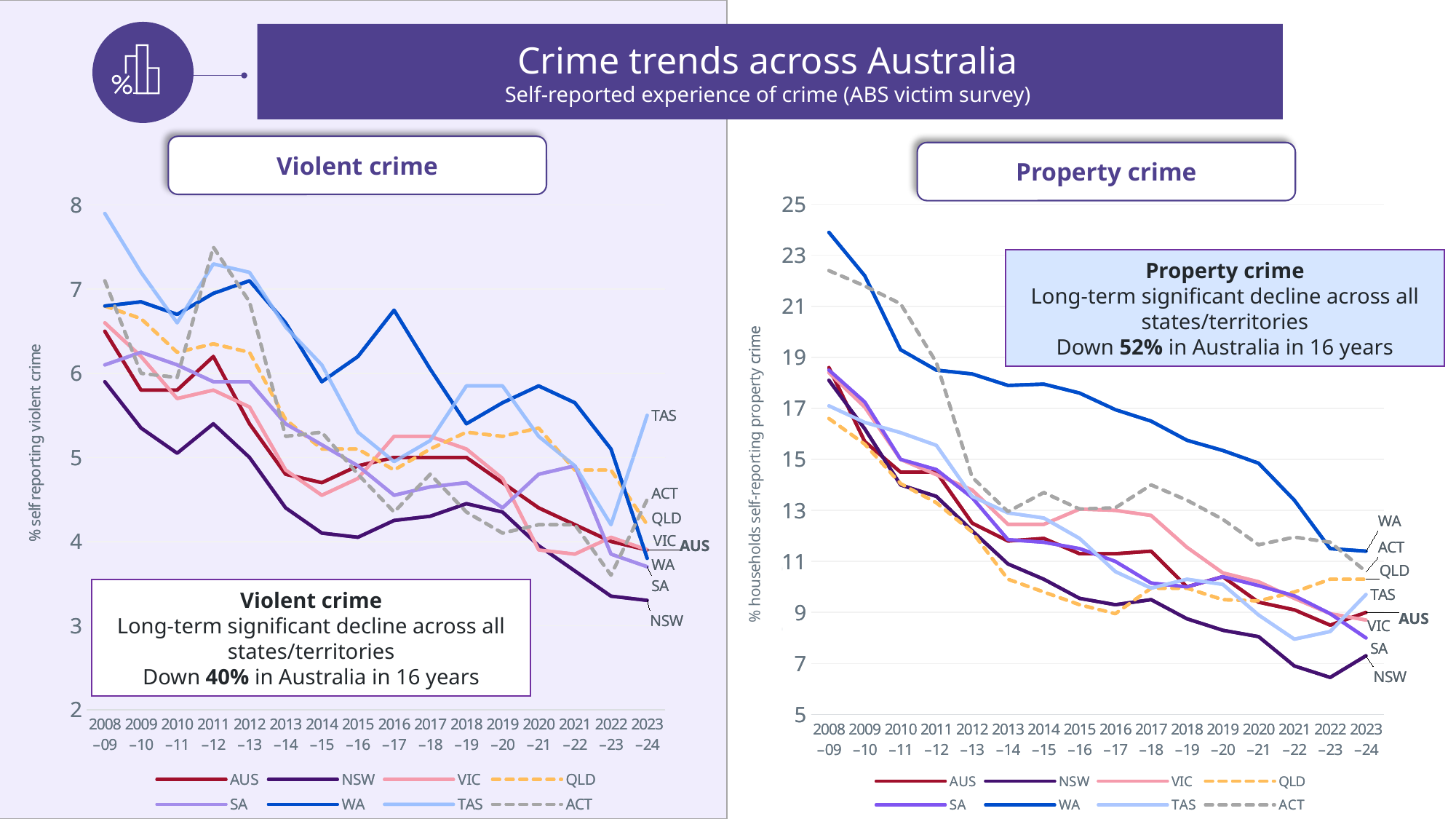
According to the text box on the Property crime chart, by what percentage has property crime fallen in Australia in 16 years? 52% In the Property crime chart, is the value for WA in 2008-09 greater or less than 23? greater In the Violent crime chart, which series has the lowest value in 2023-24? NSW In the Violent crime chart, which series has the highest value in 2008-09? TAS In the Property crime chart, does the AUS series generally rise or fall from 2008-09 to 2023-24? fall What kind of chart is the Violent crime chart? line chart How many series does the legend of the Property crime chart list? 8 In the Property crime chart, which series has the highest value in 2008-09? WA How many time points are plotted along the x axis of the Violent crime chart? 16 In the Violent crime chart, is the value for NSW in 2023-24 greater or less than 4? less In the Property crime chart, is the value for NSW in 2023-24 greater or less than 9? less